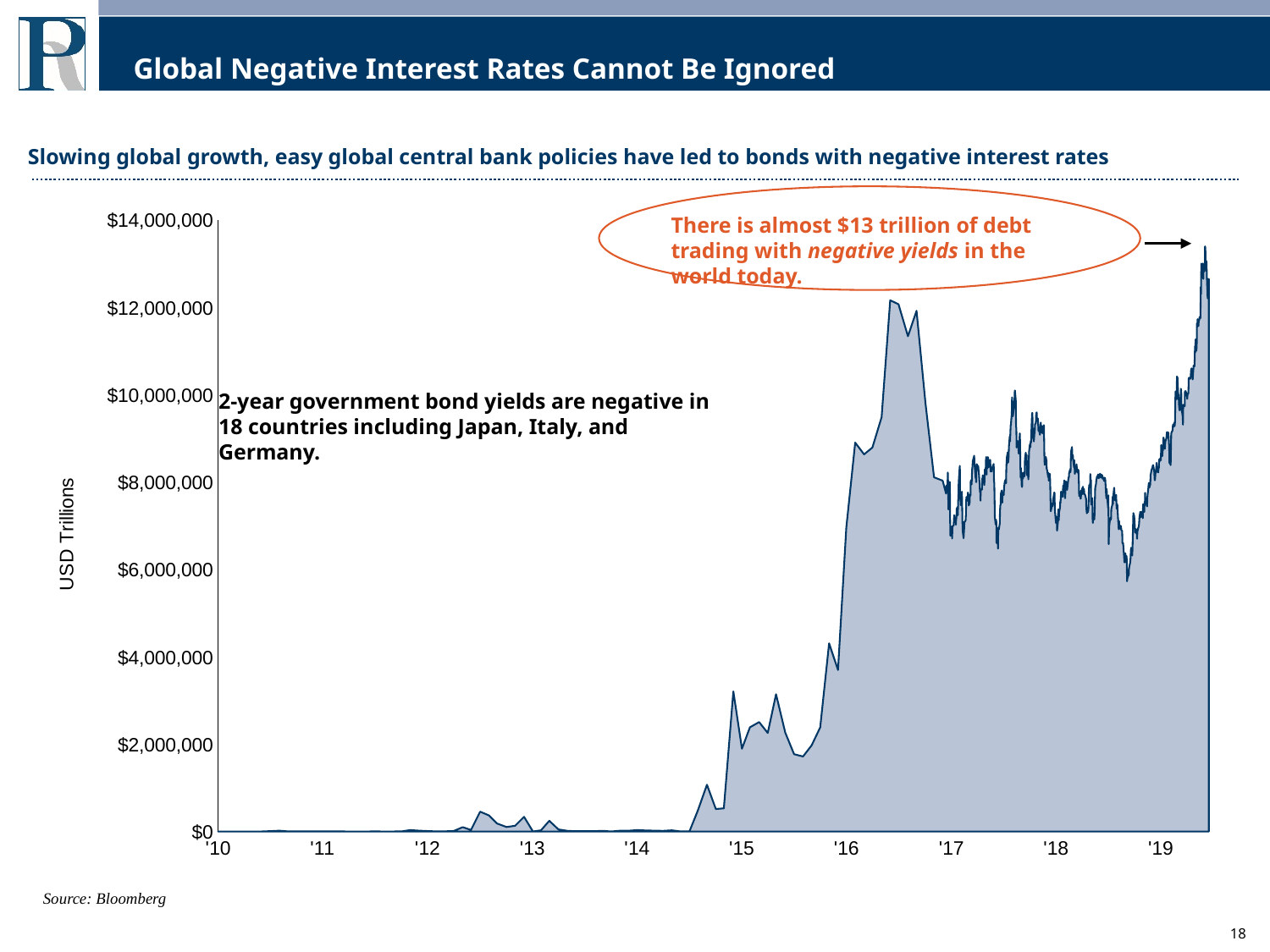
Is the peak value reached in mid-2016 greater or less than $10,000,000? Greater How many year labels are shown along the x axis of the chart? 10 Which is larger: the value at the start of '14 or the value at the start of '18? '18 Is the value at the start of '12 greater or less than $2,000,000? Less What is the label on the vertical axis of the chart? USD Trillions According to the annotation on the chart, roughly how much debt is trading with negative yields in the world today? Almost $13 trillion Is the value at the start of '14 greater or less than $2,000,000? Less Overall, do the values on the chart rise or fall from '10 to '19? Rise In which year does the chart reach its highest value? 2019 What kind of chart is shown on the slide? Area chart